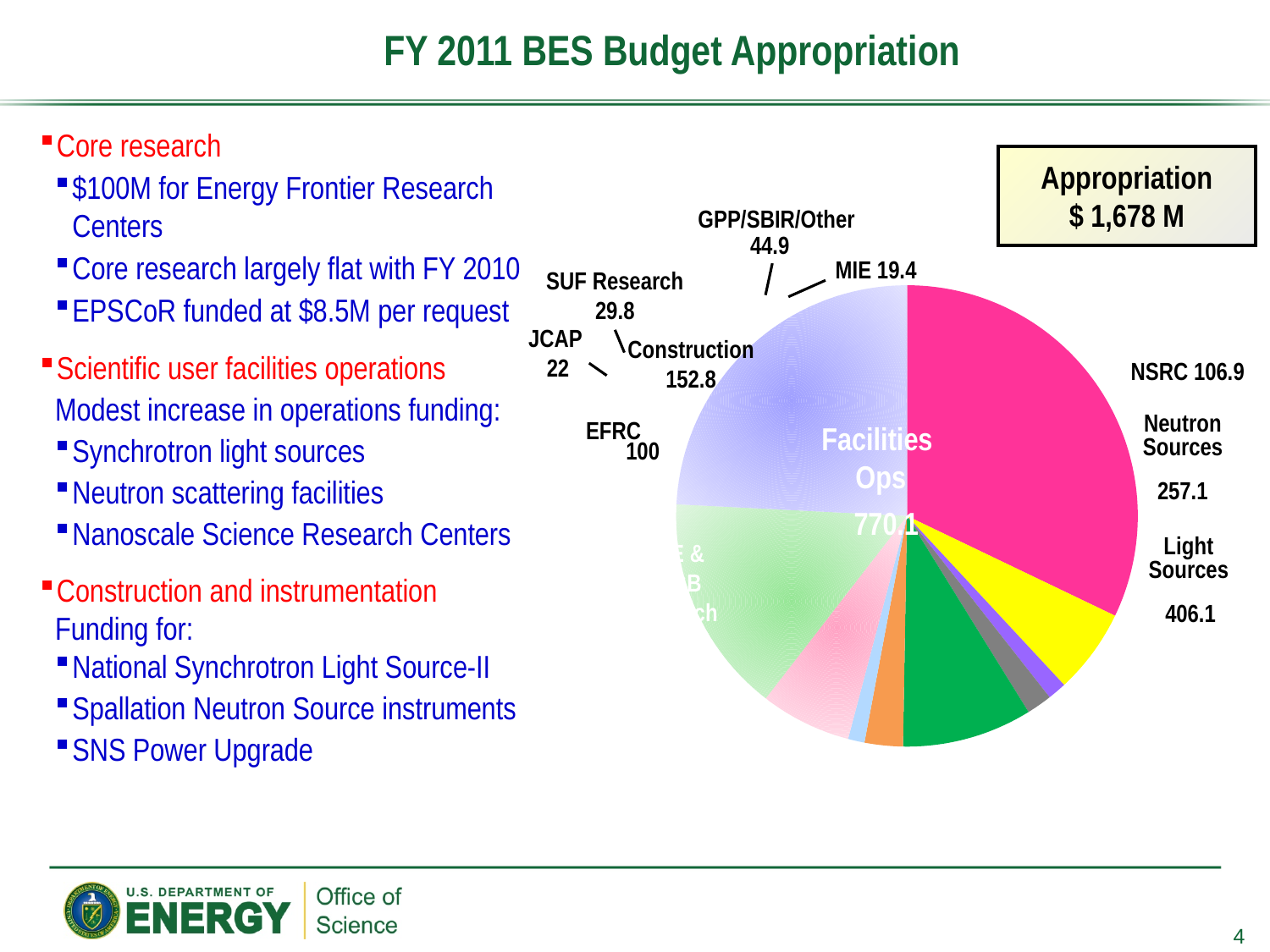
What is the value shown for NSRC in the pie chart? 106.9 Which labeled slice has the largest value in the pie chart? Facilities Ops What is the value shown for GPP/SBIR/Other in the pie chart? 44.9 What is the value shown for Light Sources in the pie chart? 406.1 What is the value shown for Neutron Sources in the pie chart? 257.1 What is the difference between the Light Sources value and the Neutron Sources value? 149.0 Which is larger, the value for Construction or the value for EFRC? Construction What kind of chart is shown on the slide? Pie chart What is the value shown for EFRC in the pie chart? 100 What is the value shown for Construction in the pie chart? 152.8 Which labeled slice has the smallest value in the pie chart? MIE What total appropriation amount is shown in the box on the slide? $ 1,678 M